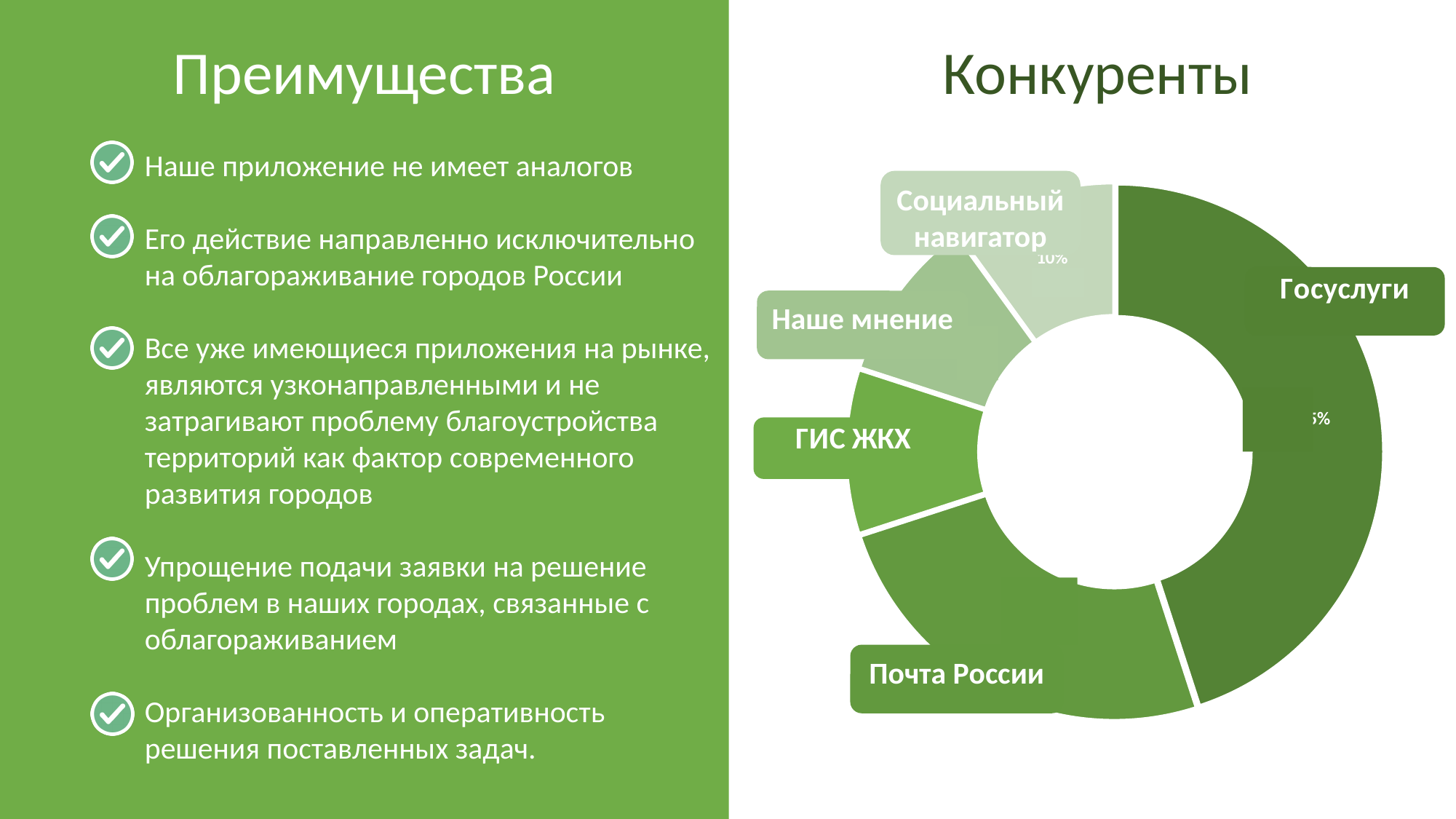
In the "Конкуренты" chart, which is larger: Госуслуги or Социальный навигатор? Госуслуги Which segment of the "Конкуренты" chart is the largest? Госуслуги Which segment of the "Конкуренты" chart is drawn in the darkest green? Госуслуги How many segments does the "Конкуренты" donut chart have? 5 What kind of chart is shown under the title "Конкуренты"? Donut (pie) chart What is the title of the chart on the right side of the slide? Конкуренты In the "Конкуренты" chart, which is larger: Госуслуги or Почта России? Госуслуги In the "Конкуренты" chart, which is larger: Почта России or ГИС ЖКХ? Почта России